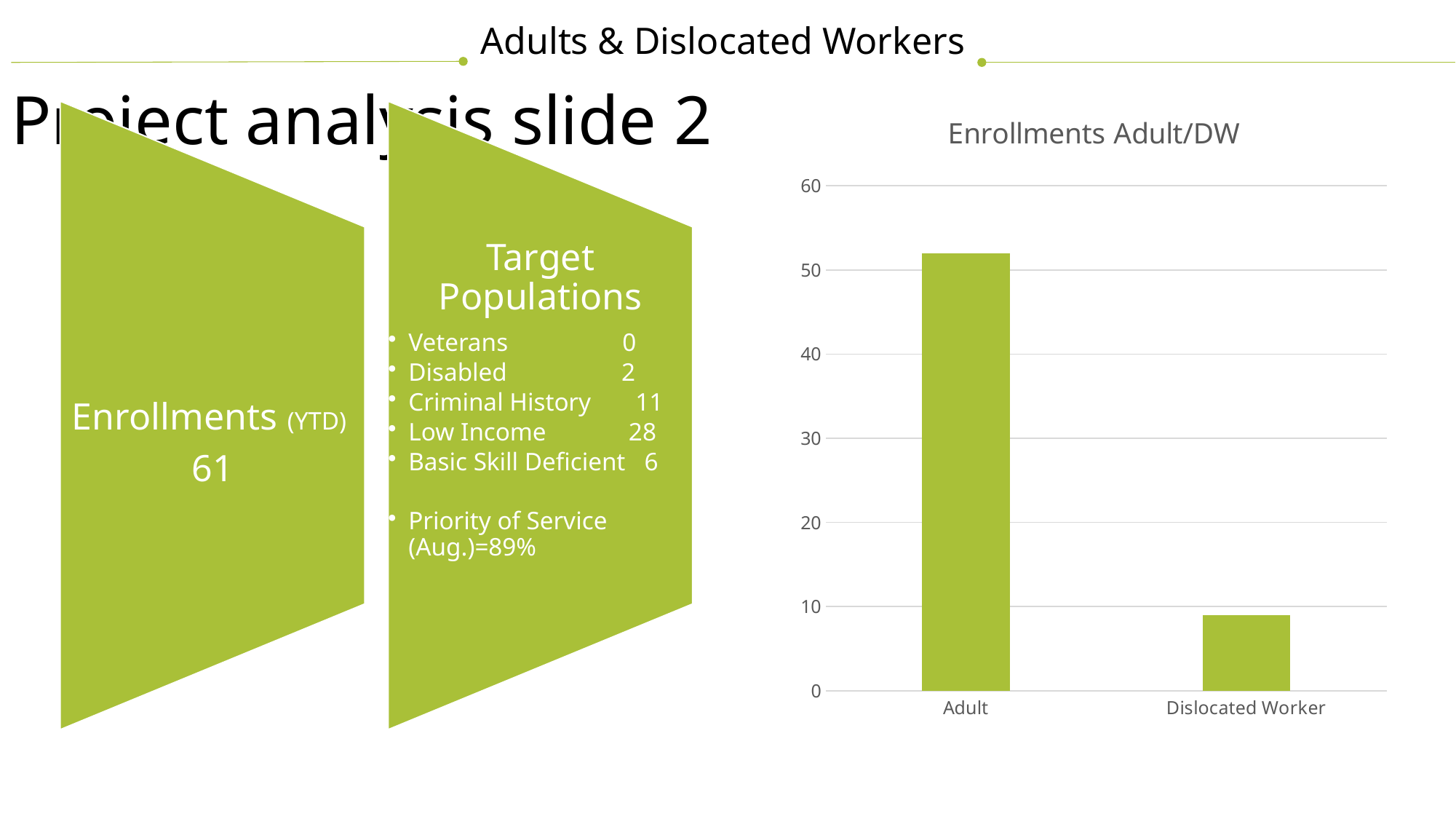
Which category has the highest value in the chart? Adult What type of chart is shown on the slide? bar chart What is the title of the chart on the slide? Enrollments Adult/DW How many categories are shown on the x axis of the chart? 2 Is the value for Adult greater or less than 40? greater Which category has the lowest value in the chart? Dislocated Worker What is the highest value shown on the y axis of the chart? 60 Is the value for Dislocated Worker greater or less than 20? less Do the values rise or fall from Adult to Dislocated Worker along the x axis? fall Which is larger in the chart, the value for Adult or the value for Dislocated Worker? Adult Is the value for Adult greater or less than 60? less